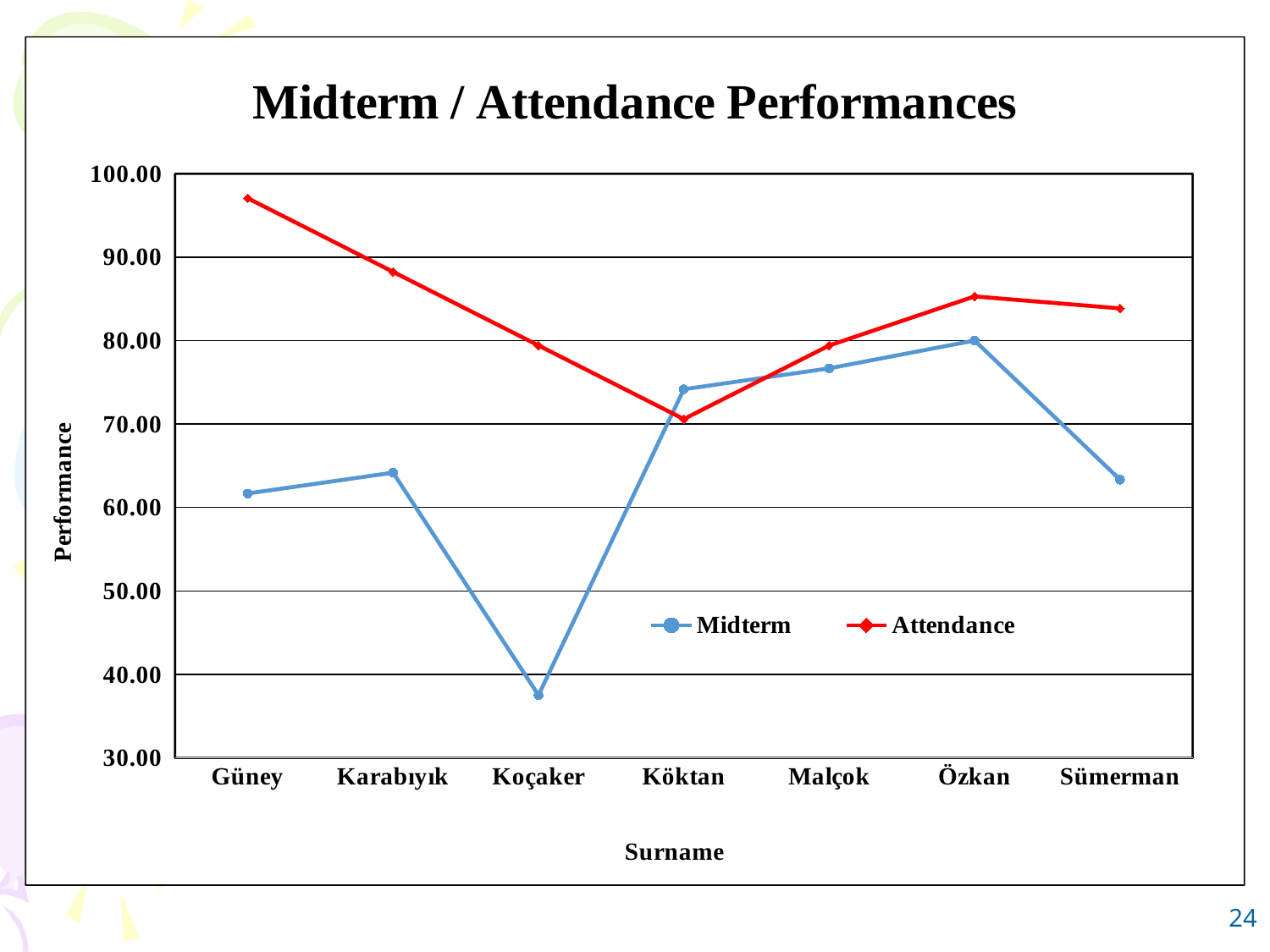
Which surname has the highest Attendance value? Güney Which surname has the lowest Midterm value? Koçaker What kind of chart is shown on the slide? line chart What is the title of the chart? Midterm / Attendance Performances How many series does the legend list? 2 Which surname has the lowest Attendance value? Köktan For Karabıyık, which is larger, the Midterm value or the Attendance value? Attendance Which surname has the highest Midterm value? Özkan How many surnames are plotted along the x axis? 7 Is the Midterm value for Koçaker greater or less than 40.00? less Does the Attendance line rise or fall from Güney to Köktan? fall Is the Attendance value for Güney greater or less than 90.00? greater